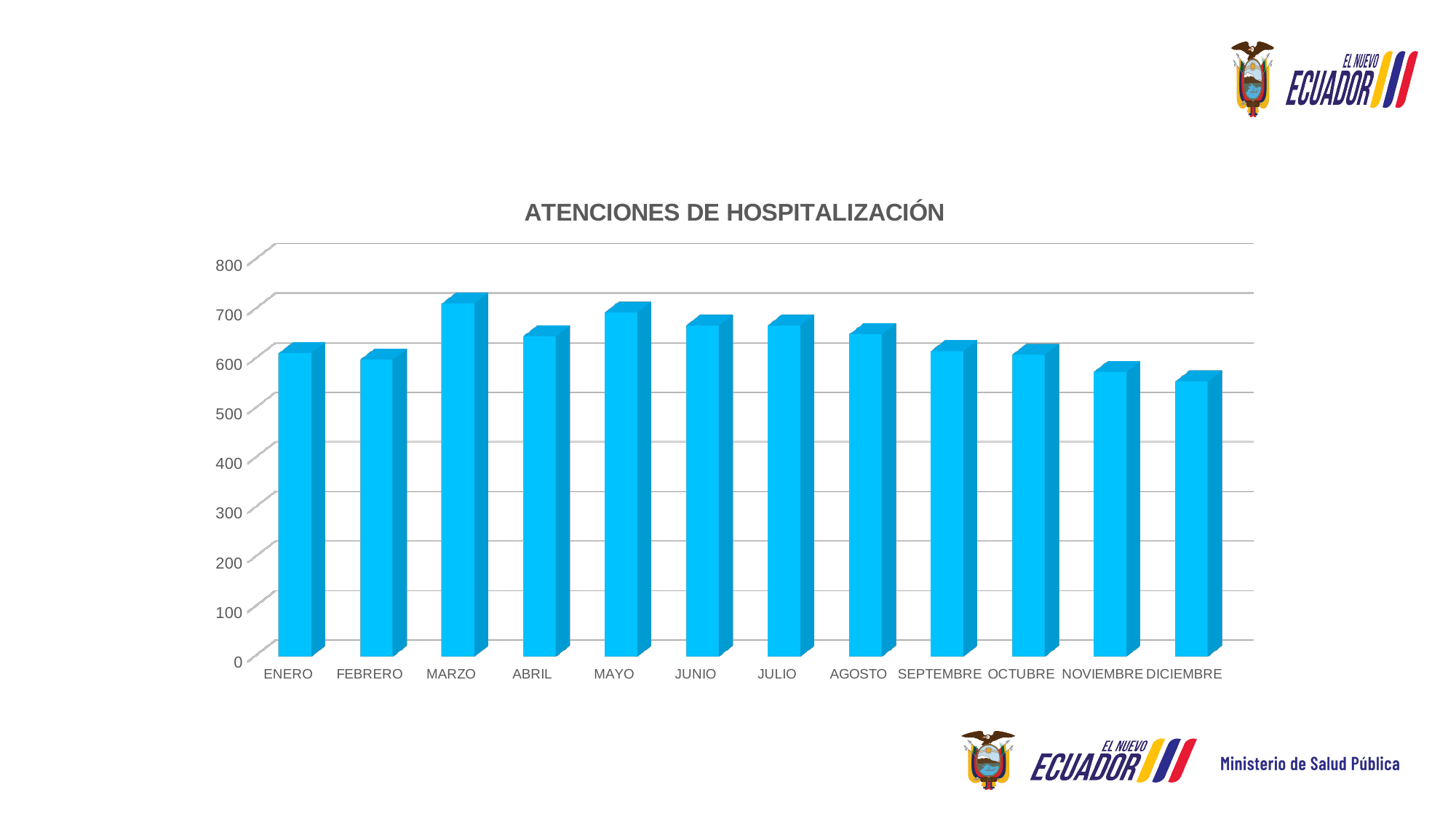
Is the value for ABRIL greater or less than 600? greater Which is larger, the value for MAYO or the value for DICIEMBRE? MAYO What kind of chart is shown on the slide? bar chart Which month has the highest value? MARZO Which is larger, the value for MARZO or the value for FEBRERO? MARZO What is the title of the chart? ATENCIONES DE HOSPITALIZACIÓN Is the value for NOVIEMBRE greater or less than 500? greater Is the value for DICIEMBRE greater or less than 600? less From MARZO to DICIEMBRE, do the values generally rise or fall? fall How many months (categories) are plotted on the chart? 12 Which month has the lowest value? DICIEMBRE